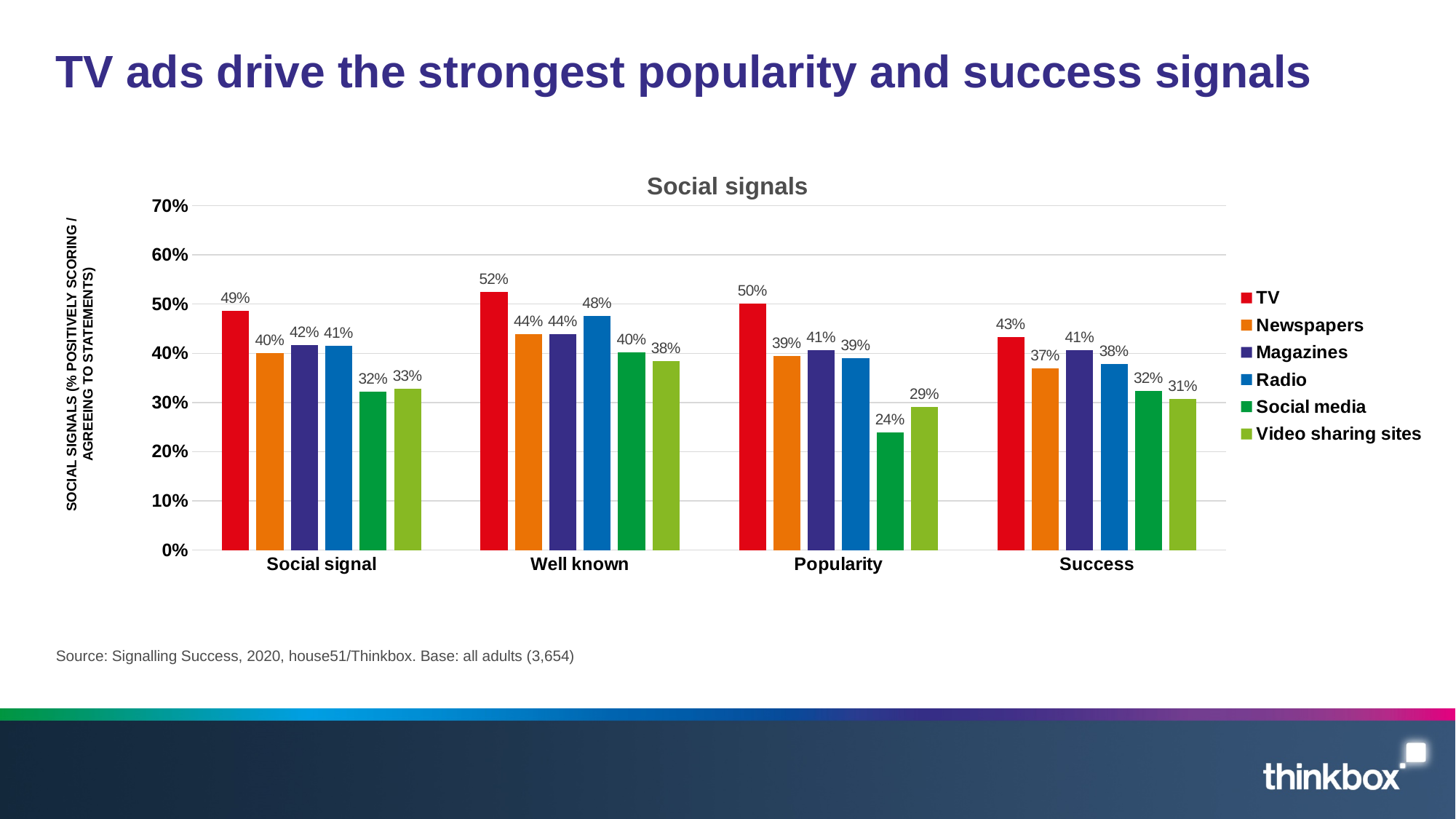
What is the value for Social media in the Popularity category? 24% What is the value for TV in the Well known category? 52% Which is larger in the Well known category: Radio or Social media? Radio What is the difference between TV and Newspapers in the Social signal category? 9% How many categories are shown on the x axis? 4 Which series has the lowest value in the Success category? Video sharing sites Which series has the highest value in the Popularity category? TV What colour represents Newspapers in the chart? Orange How many series does the legend list? 6 What is the value for Radio in the Success category? 38% What is the title of the chart? Social signals What kind of chart is shown on the slide? Bar chart